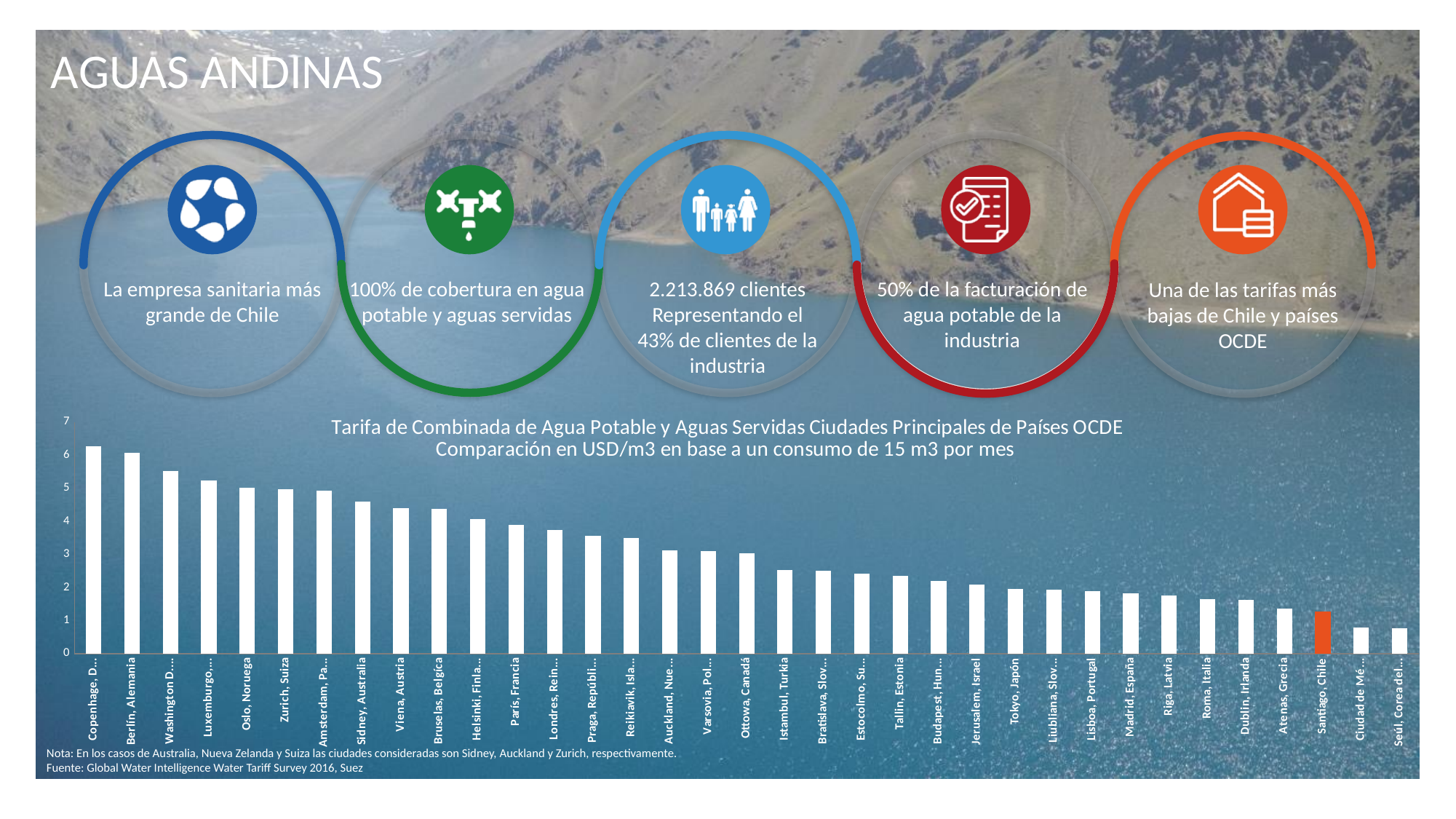
Is the value for Santiago, Chile greater or less than 2? less Is the value for París, Francia greater or less than 3? greater Which city has the highest combined water tariff in the chart? Copenhage, D... Which bar in the chart is highlighted in orange? Santiago, Chile Which has a larger value, Berlín, Alemania or Madrid, España? Berlín, Alemania Do the bar values rise or fall from left to right along the x axis? fall Is the value for Berlín, Alemania greater or less than 5? greater Which has a larger value, Santiago, Chile or Oslo, Noruega? Oslo, Noruega What unit is the tariff comparison in the chart expressed in, according to the chart title? USD/m3 What kind of chart is shown on the slide? bar chart How many cities (bars) are shown in the chart? 35